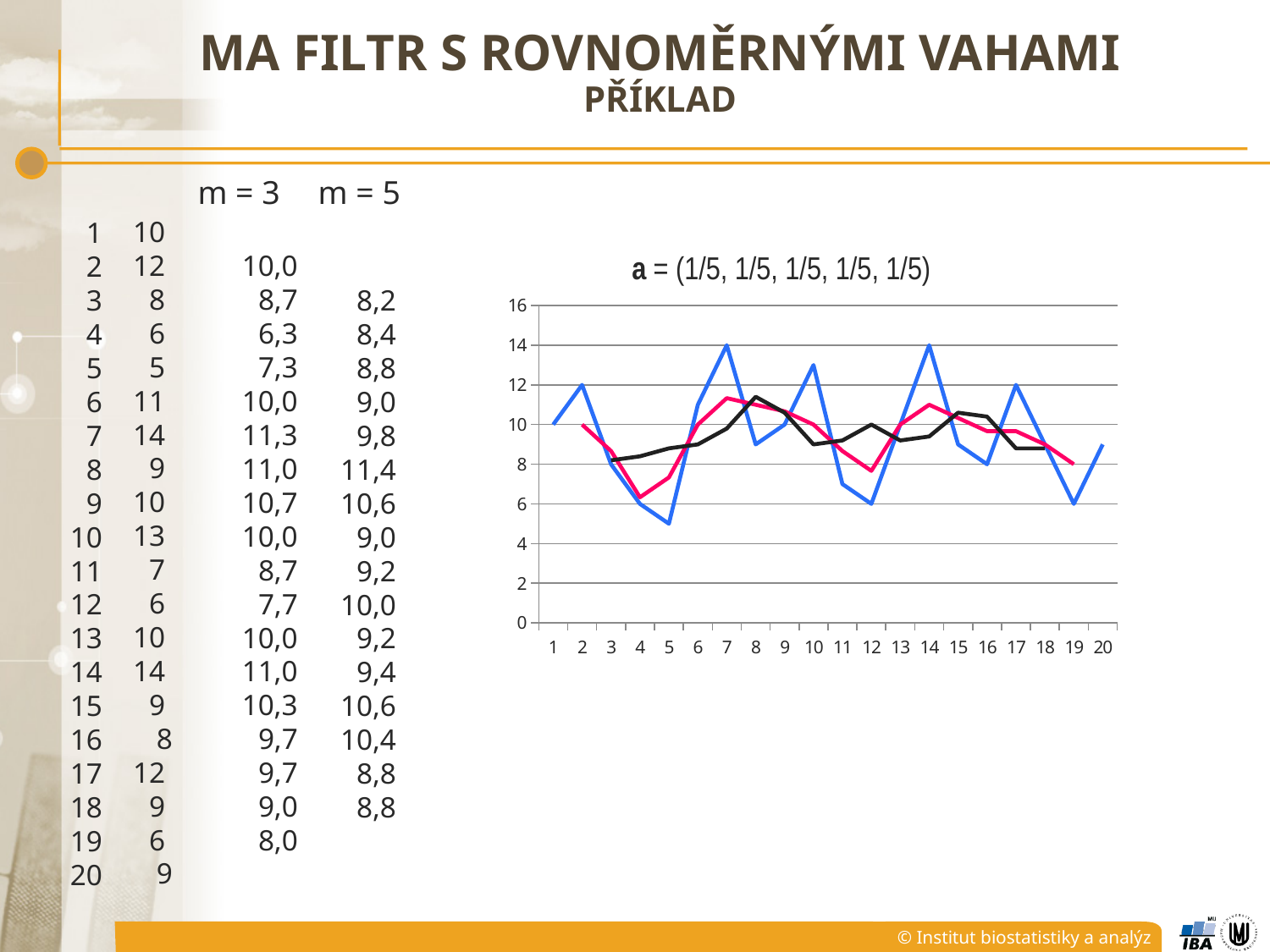
What type of chart is shown on the slide? line chart What is the title shown above the chart? a = (1/5, 1/5, 1/5, 1/5, 1/5) Is the value of the blue line at point 10 greater or less than 12? greater How many lines are plotted on the chart? 3 What is the value of the blue line at point 12? 6 How many points are labelled along the x axis of the chart? 20 Is the value of the black line at point 4 greater or less than 10? less Is the value of the blue line at point 5 greater or less than 6? less What is the value of the blue line at point 1? 10 Does the blue line rise or fall from point 14 to point 16? fall What is the highest value reached by the blue line? 14 At point 12, which line has the larger value, the blue line or the black line? black line